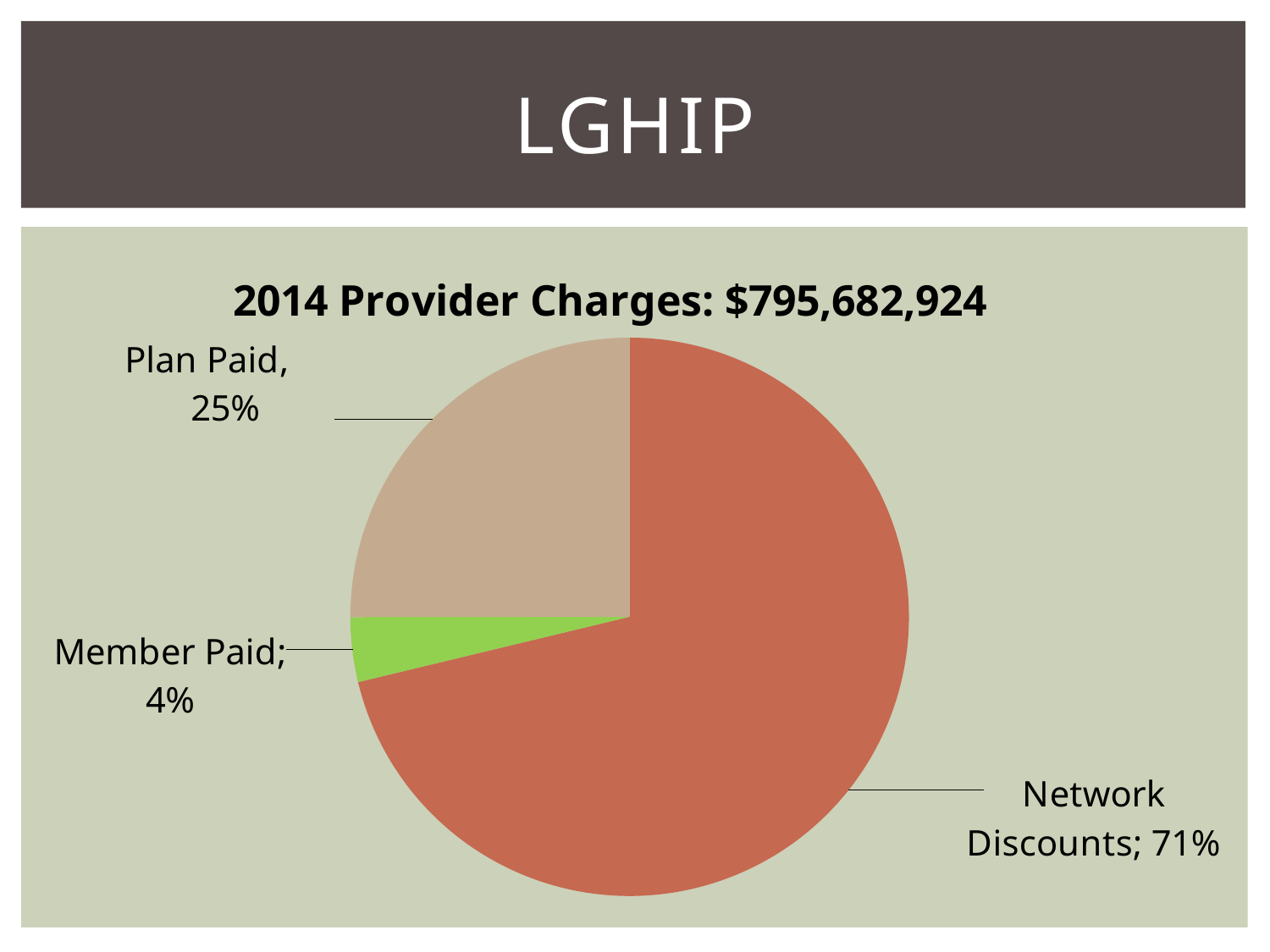
What is the difference in percentage points between Network Discounts and Plan Paid? 46 What total provider charges amount is stated in the chart title? $795,682,924 What share of the pie is Network Discounts? 71% How many slices does the pie chart have? 3 What is the chart's title? 2014 Provider Charges: $795,682,924 Which is larger, Plan Paid or Member Paid? Plan Paid Which slice is the smallest? Member Paid Which slice is the largest? Network Discounts What kind of chart is shown on the slide? pie chart What is the difference in percentage points between Plan Paid and Member Paid? 21 What share of the pie is Member Paid? 4% What share of the pie is Plan Paid? 25%